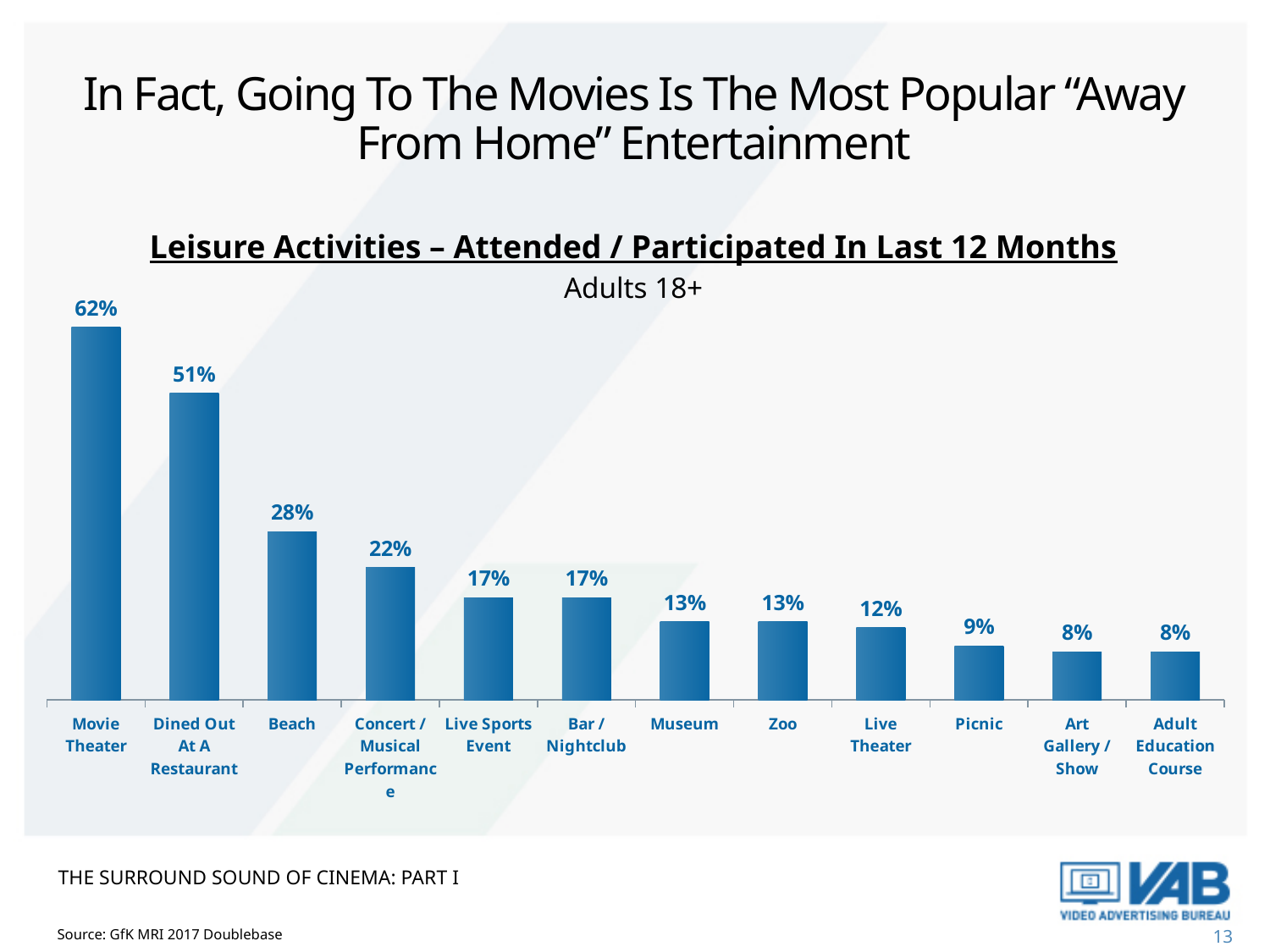
What is the title of the chart? Leisure Activities – Attended / Participated In Last 12 Months What is the value for Beach? 28% Which leisure activity has the highest value? Movie Theater Which is larger, the value for Museum or the value for Picnic? Museum What is the difference between the values for Movie Theater and Dined Out At A Restaurant? 11% What is the value for Zoo? 13% What kind of chart is shown on the slide? Bar chart What is the difference between the values for Beach and Concert / Musical Performance? 6% Which is larger, the value for Live Sports Event or the value for Live Theater? Live Sports Event How many leisure activities are shown in the chart? 12 What percentage of adults 18+ attended a movie theater in the last 12 months? 62% Do the values rise or fall moving from left to right along the x axis? Fall